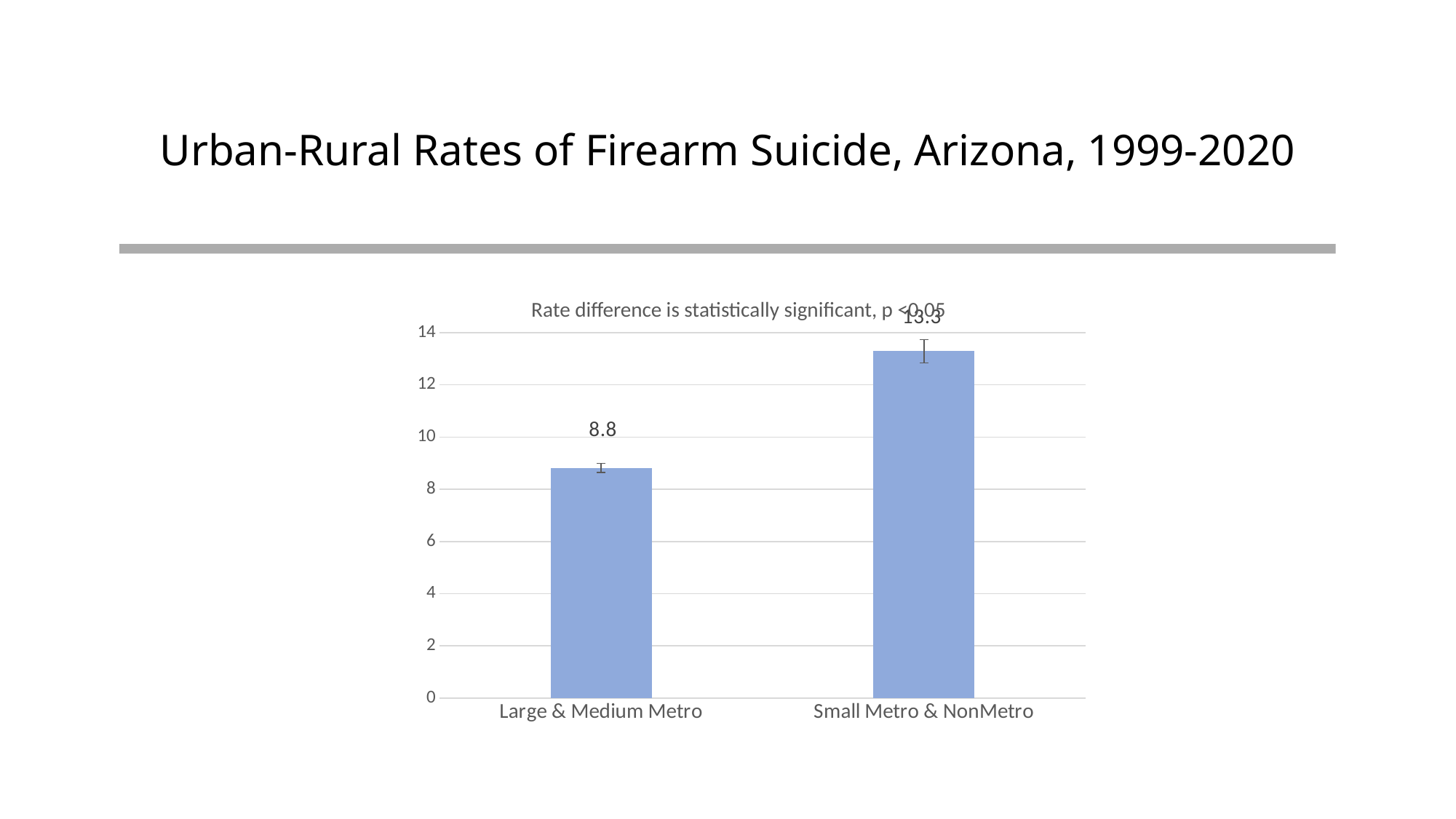
What is the title of the slide? Urban-Rural Rates of Firearm Suicide, Arizona, 1999-2020 How many categories are shown on the chart? 2 What is the maximum value shown on the vertical axis? 14 What is the difference between the Small Metro & NonMetro rate and the Large & Medium Metro rate? 4.5 Is the rate for Small Metro & NonMetro greater or less than 12? greater What is the firearm suicide rate for Small Metro & NonMetro? 13.3 Is the rate for Large & Medium Metro greater or less than 10? less Which category has the higher firearm suicide rate? Small Metro & NonMetro What is the firearm suicide rate for Large & Medium Metro? 8.8 Which category has the lower firearm suicide rate? Large & Medium Metro What kind of chart is shown on the slide? bar chart